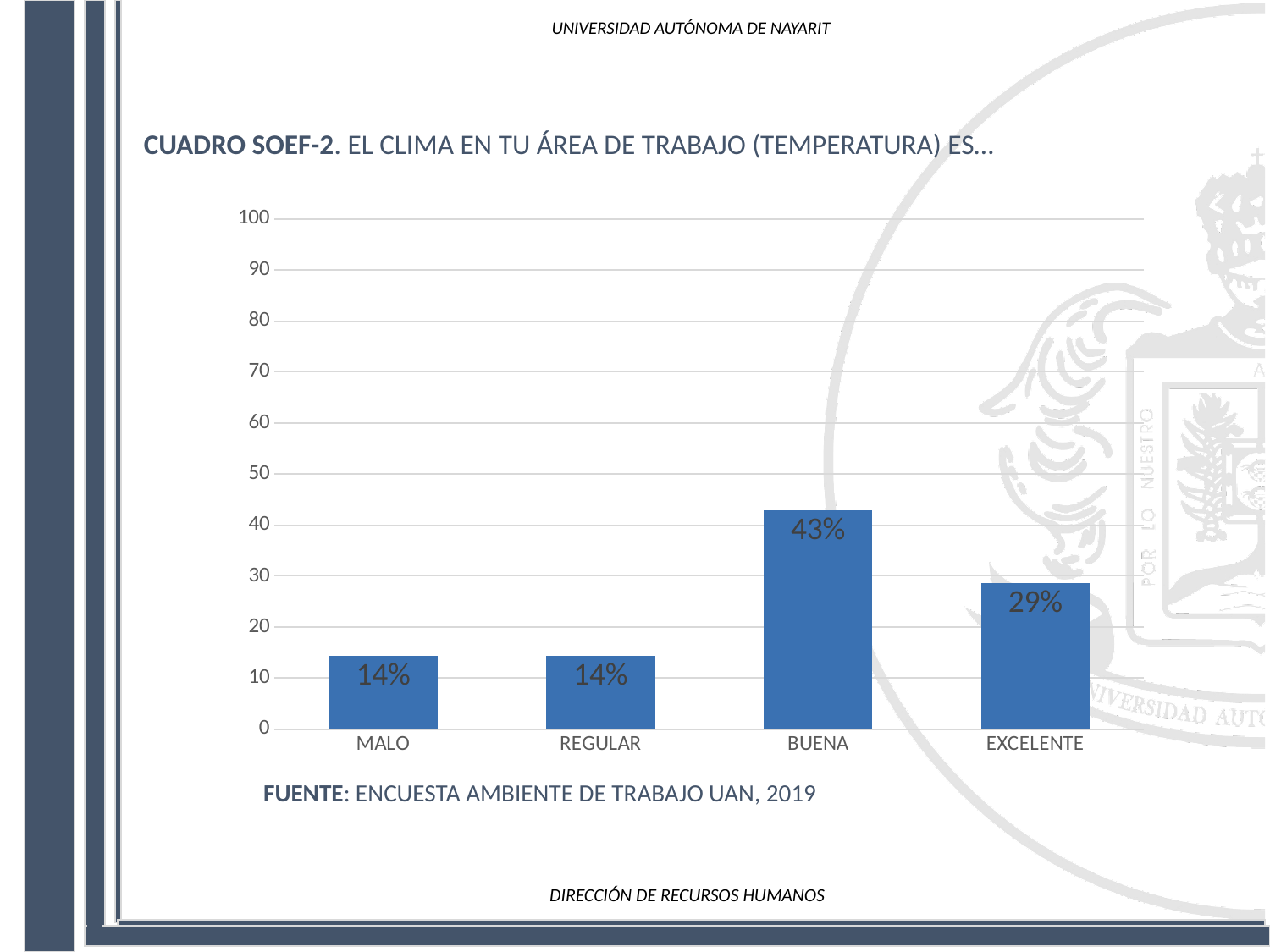
How many categories are shown on the x axis? 4 Is the value for REGULAR greater or less than 20? less What is the source cited below the chart? ENCUESTA AMBIENTE DE TRABAJO UAN, 2019 What is the value for EXCELENTE? 29% Which is larger, the value for EXCELENTE or the value for MALO? EXCELENTE What is the value for MALO? 14% Which category has the highest value? BUENA What kind of chart is shown on the slide? bar chart What is the difference between the values for BUENA and EXCELENTE? 14% Is the value for BUENA greater or less than 40? greater What is the difference between the values for EXCELENTE and REGULAR? 15% What is the value for BUENA? 43%